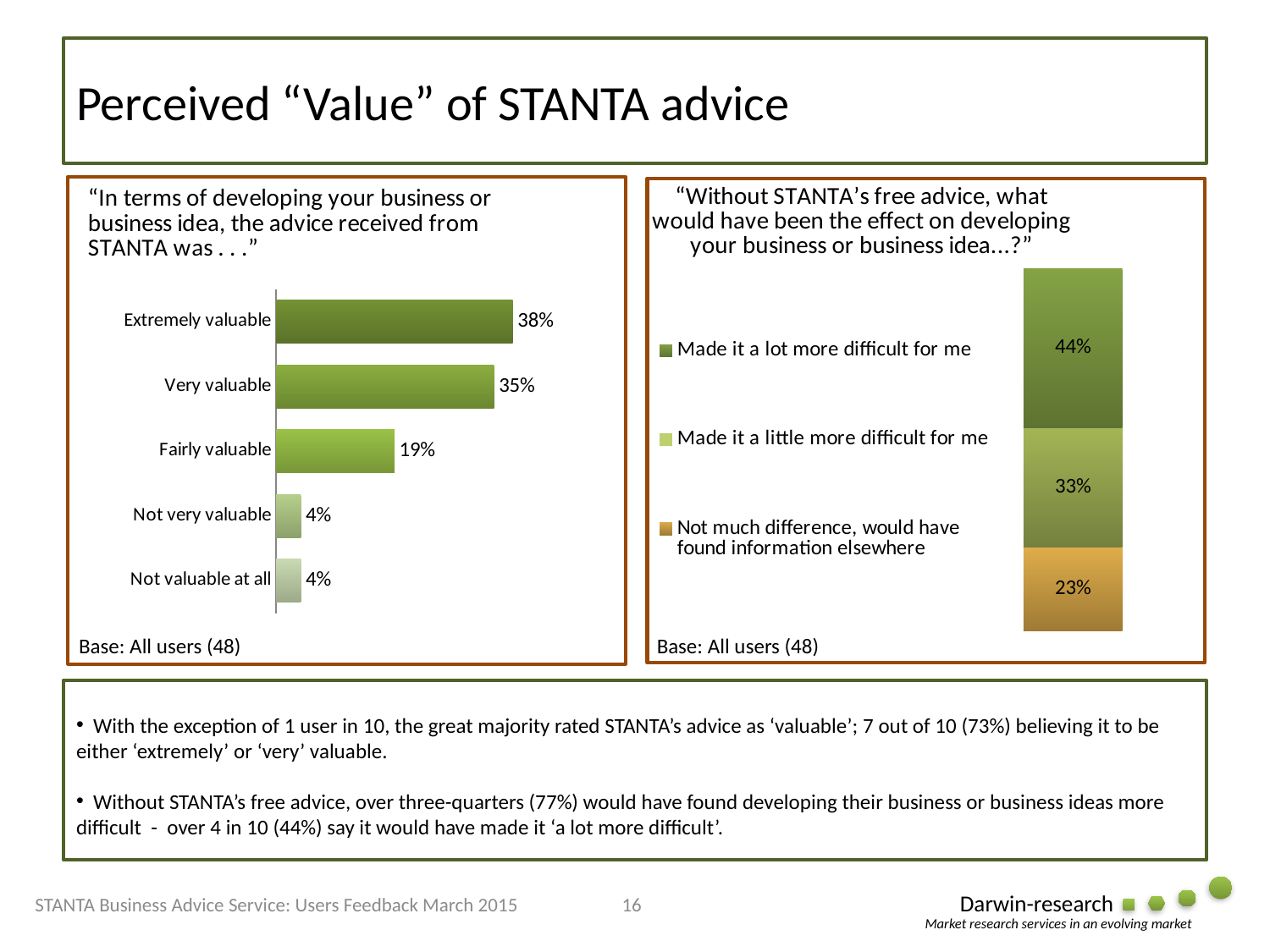
What kind of chart is the left chart ("the advice received from STANTA was . . .")? Bar chart In the left chart ("the advice received from STANTA was . . ."), what percentage of users said the advice was Extremely valuable? 38% In the right chart ("Without STANTA's free advice..."), what percentage said it would have made it a lot more difficult for them? 44% In the right chart ("Without STANTA's free advice..."), which response has the smallest share? Not much difference, would have found information elsewhere In the left chart ("the advice received from STANTA was . . ."), which is larger: Extremely valuable or Very valuable? Extremely valuable In the left chart ("the advice received from STANTA was . . ."), what is the difference between the Very valuable and Fairly valuable percentages? 16% In the left chart ("the advice received from STANTA was . . ."), what percentage of users said the advice was Fairly valuable? 19% How many series does the legend of the right chart ("Without STANTA's free advice...") list? 3 In the right chart ("Without STANTA's free advice..."), what percentage said it would have made not much difference, they would have found information elsewhere? 23% In the right chart ("Without STANTA's free advice..."), what is the difference between the 'a lot more difficult' and 'a little more difficult' percentages? 11% How many categories are shown in the left chart ("the advice received from STANTA was . . .")? 5 In the left chart ("the advice received from STANTA was . . ."), which category has the highest value? Extremely valuable